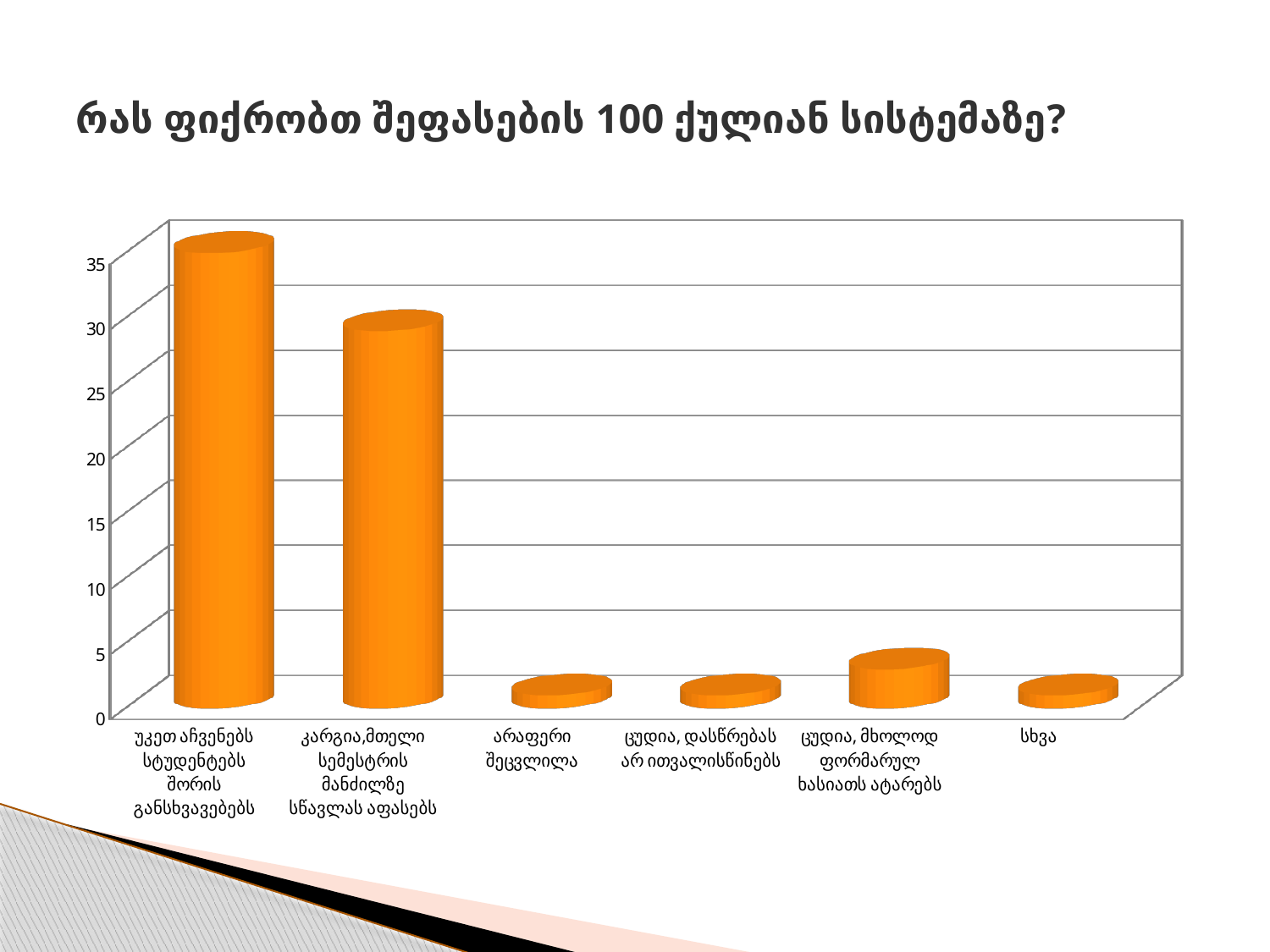
What kind of chart is shown on the slide? bar chart Which category has the highest bar in the chart? უკეთ აჩვენებს სტუდენტებს შორის განსხვავებებს What is the title of the slide above the chart? რას ფიქრობთ შეფასების 100 ქულიან სისტემაზე? Which is larger: the value for "უკეთ ახვენებს სტუდენტებს შორის განსხვავებებს" or the value for "კარგია,მთელი სემესტრის მანძილზე სწავლას აფასებს"? უკეთ აჩვენებს სტუდენტებს შორის განსხვავებებს Is the value for "კარგია,მთელი სემესტრის მანძილზე სწავლას აფასებს" greater or less than 35? less What colour are the bars in the chart? orange Which is larger: the value for "ცუდია, მხოლოდ ფორმარულ ხასიათს ატარებს" or the value for "არაფერი შეცვლილა"? ცუდია, მხოლოდ ფორმარულ ხასიათს ატარებს How many categories are shown on the x axis of the chart? 6 Is the value for "უკეთ ახვენებს სტუდენტებს შორის განსხვავებებს" greater or less than 30? greater Is the value for "კარგია,მთელი სემესტრის მანძილზე სწავლას აფასებს" greater or less than 25? greater